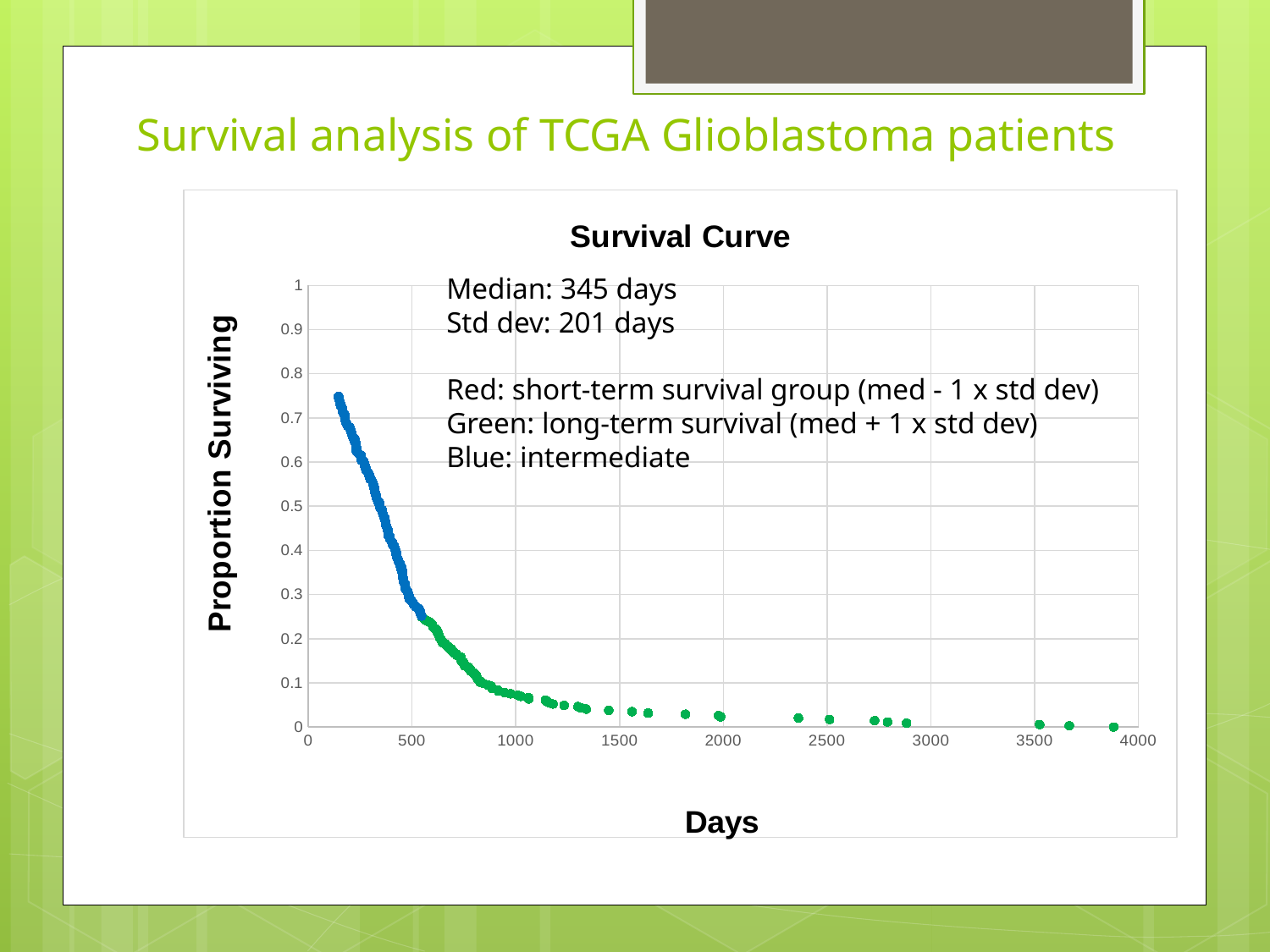
What is the highest value shown on the x axis (Days)? 4000 What kind of chart is shown on the slide? Scatter chart What is the title of the chart? Survival Curve Does the proportion surviving rise or fall as the number of days increases? Fall Is the proportion surviving at 200 days greater or less than 0.5? greater Is the proportion surviving at 2000 days greater or less than 0.1? less What is the label of the y axis? Proportion Surviving